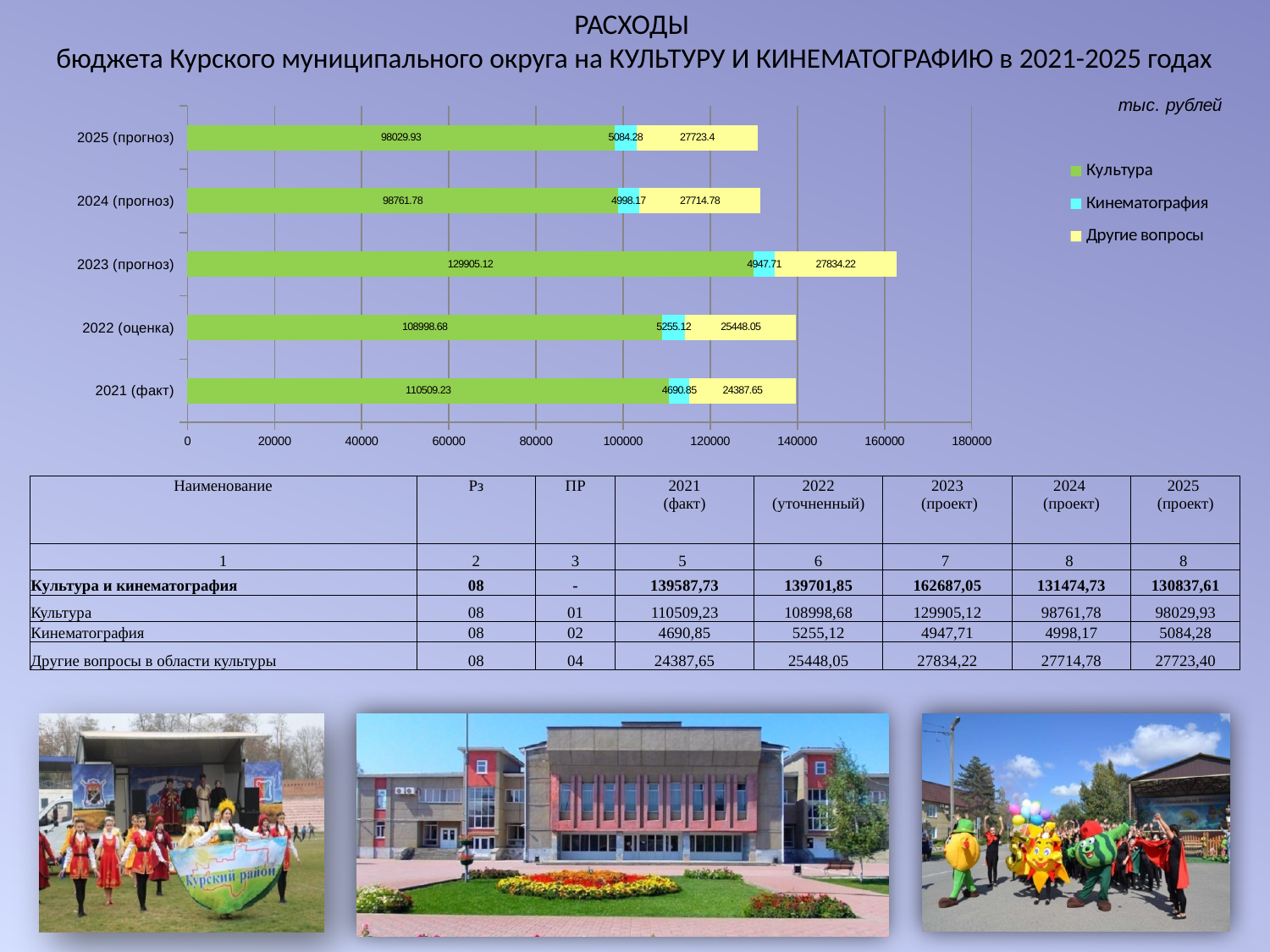
Which year has the highest value for Культура? 2023 (прогноз) What is the value of Культура for 2023 (прогноз)? 129905.12 What is the difference between the Культура values for 2021 (факт) and 2022 (оценка)? 1510.55 Which year has the lowest value for Кинематография? 2021 (факт) What is the total of the stacked bar for 2025 (прогноз)? 130837.61 How many series does the chart legend list? 3 What is the value of Кинематография for 2021 (факт)? 4690.85 Which is larger: Другие вопросы for 2023 (прогноз) or for 2024 (прогноз)? 2023 (прогноз) How many year categories are plotted on the chart? 5 What is the value of Другие вопросы for 2022 (оценка)? 25448.05 What type of chart is shown on the slide? Stacked bar chart Which series is shown in green on the chart? Культура